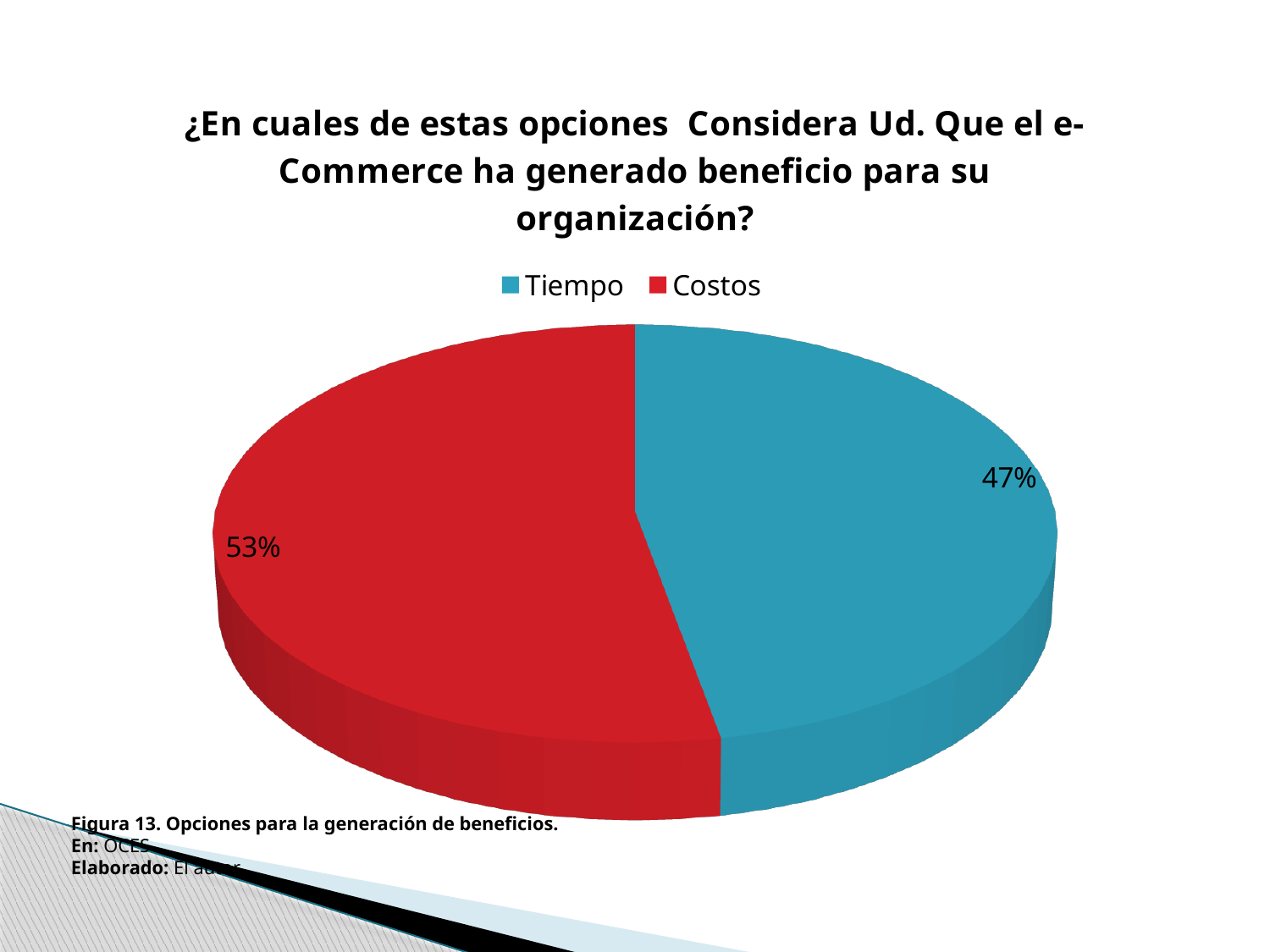
What kind of chart is shown on the slide? Pie chart Which colour represents Tiempo in the chart? Blue How many entries does the legend list? 2 How many categories does the pie chart show? 2 Which category has the smallest share of the pie? Tiempo Is the share for Costos greater or less than 50%? greater What share of the pie does Tiempo represent? 47% What share of the pie does Costos represent? 53% Which colour represents Costos in the chart? Red Which slice is larger, Tiempo or Costos? Costos What is the difference in percentage points between the Costos and Tiempo slices? 6 Which category has the largest share of the pie? Costos